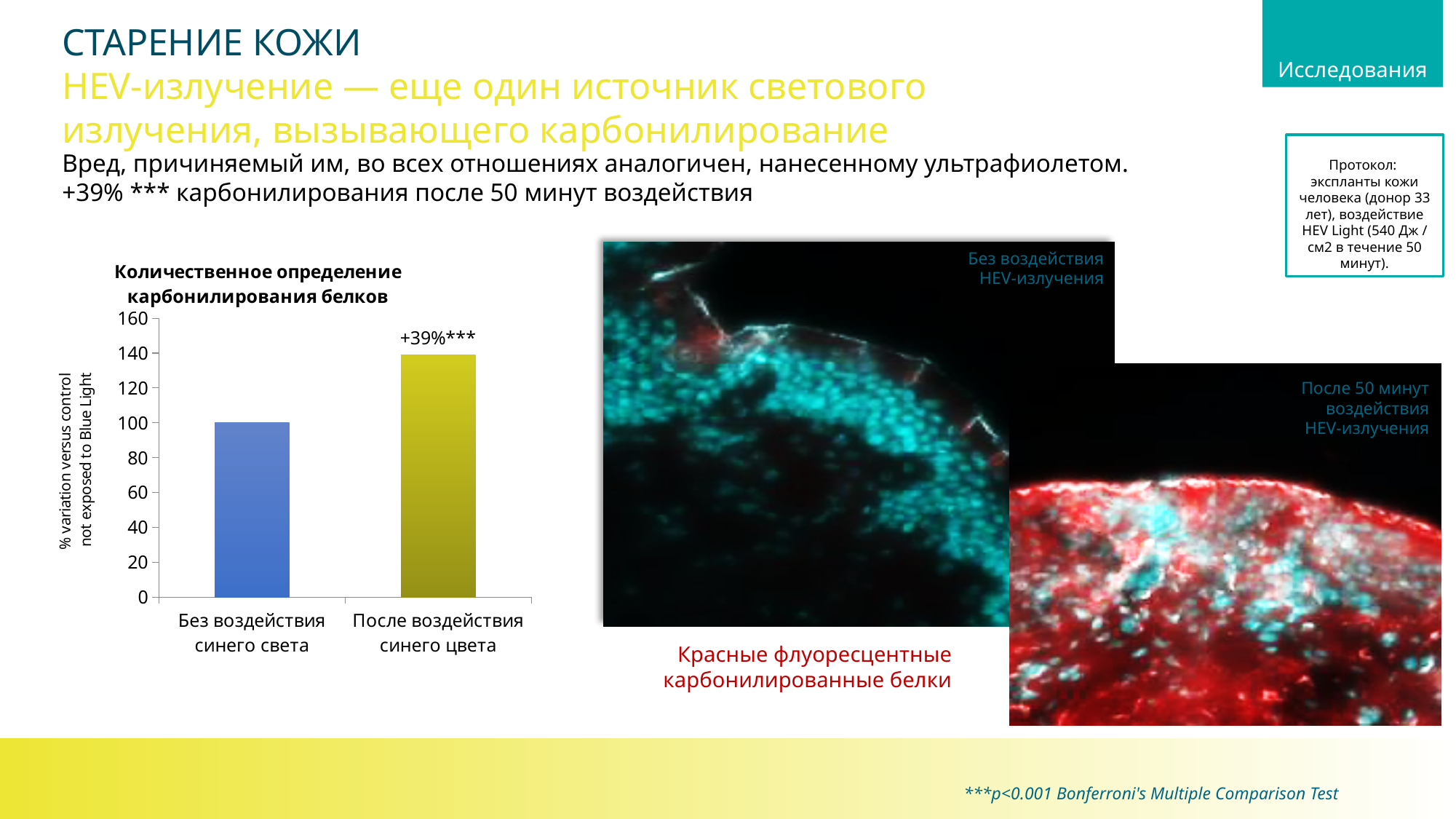
What data label is printed above the bar for "После воздействия синего цвета"? +39%*** Is the value for "После воздействия синего цвета" greater or less than 120? greater What is the highest value shown on the chart's vertical axis? 160 Which category has the highest bar? После воздействия синего цвета Do the values rise or fall from the left category to the right category? rise Which category has the lowest bar? Без воздействия синего света What is the title of the chart? Количественное определение карбонилирования белков How many categories are plotted in the chart? 2 Is the value for "Без воздействия синего света" greater or less than 120? less What type of chart is shown on the slide? bar chart What is the value for "Без воздействия синего света"? 100 Which is larger: the bar for "Без воздействия синего света" or the bar for "После воздействия синего цвета"? После воздействия синего цвета